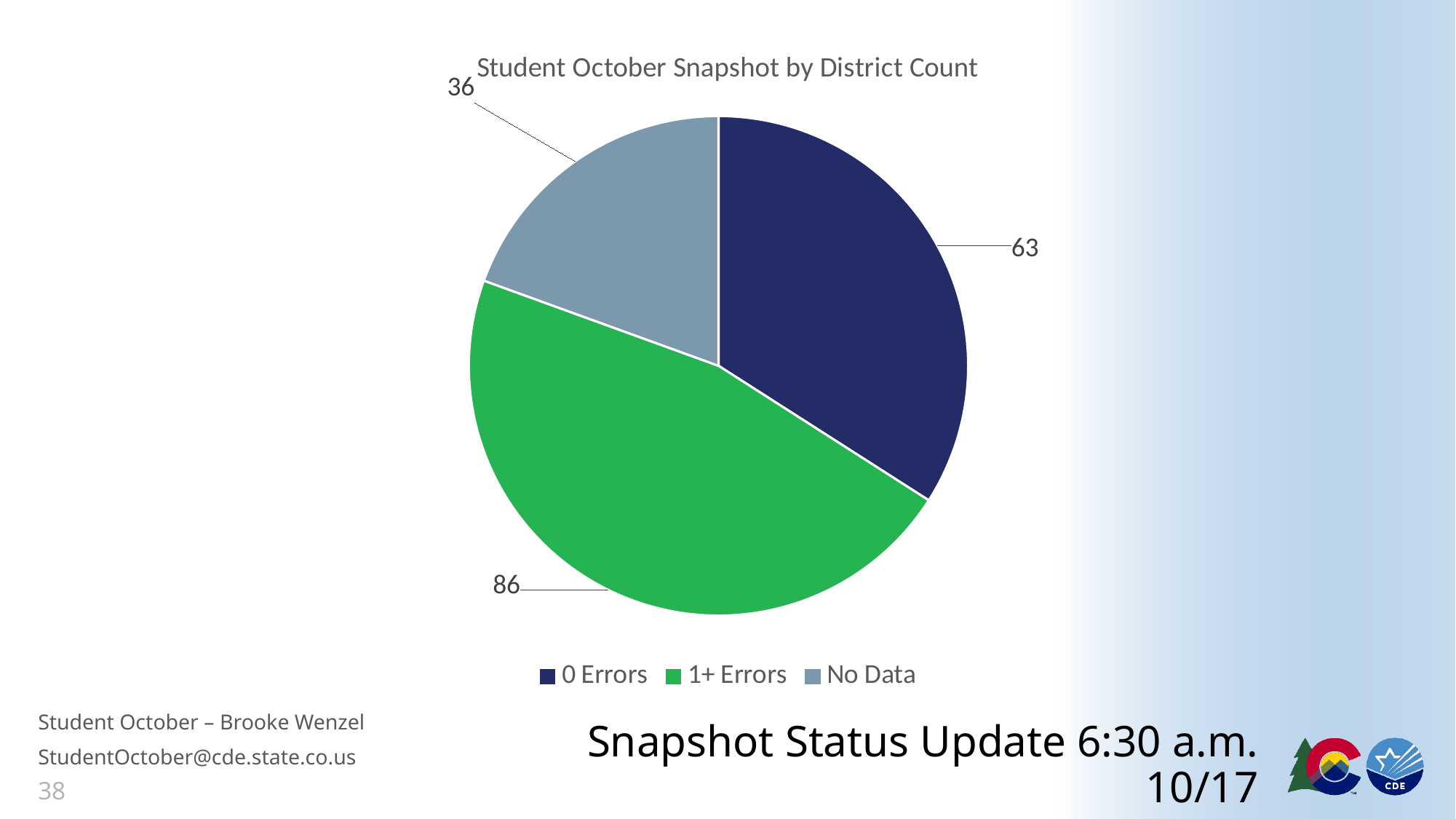
Which category has the largest slice in the pie chart? 1+ Errors What is the total of all slices in the pie chart? 185 What is the difference between the 1+ Errors value and the 0 Errors value? 23 What is the title of the chart? Student October Snapshot by District Count How many categories are shown in the pie chart? 3 What is the value for No Data in the pie chart? 36 What is the value for 1+ Errors in the Student October Snapshot by District Count pie chart? 86 What is the difference between the 0 Errors value and the No Data value? 27 Which category has the smallest slice in the pie chart? No Data What kind of chart is shown on the slide? Pie chart Which is larger, the 0 Errors slice or the No Data slice? 0 Errors What is the value for 0 Errors in the pie chart? 63